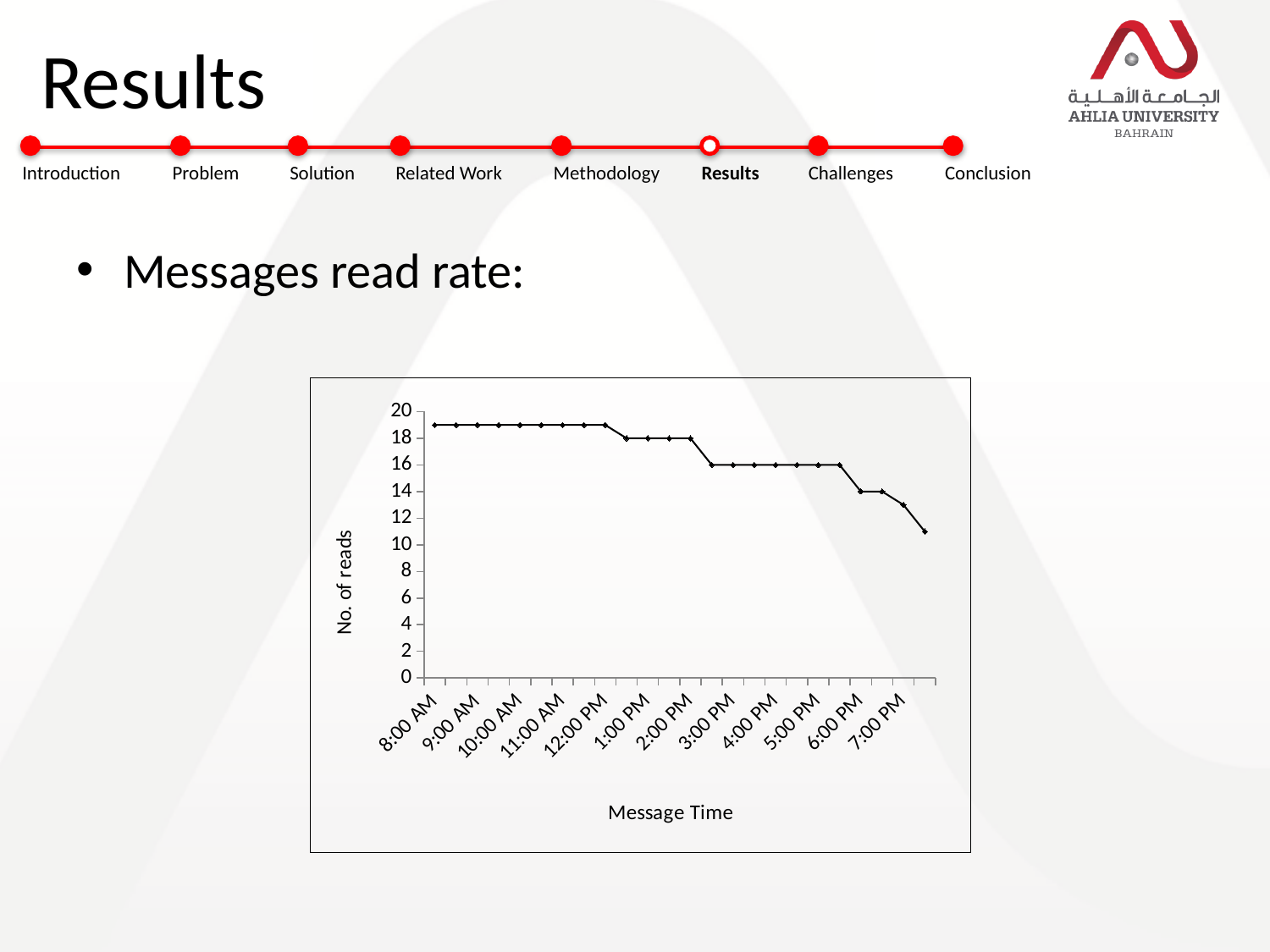
Which has more reads, 9:00 AM or 6:00 PM? 9:00 AM Is the number of reads at 10:00 AM greater or less than 16? greater How many time labels are shown along the x axis of the chart? 12 What is the title of the horizontal axis of the chart? Message Time Is the lowest value plotted in the chart greater or less than 12? less Is the number of reads at 8:00 AM greater or less than 18? greater What is the title of the vertical axis of the chart? No. of reads Do the values in the chart generally rise or fall from 8:00 AM to 7:00 PM? fall Which has fewer reads, 11:00 AM or 7:00 PM? 7:00 PM What kind of chart is shown on the slide? line chart